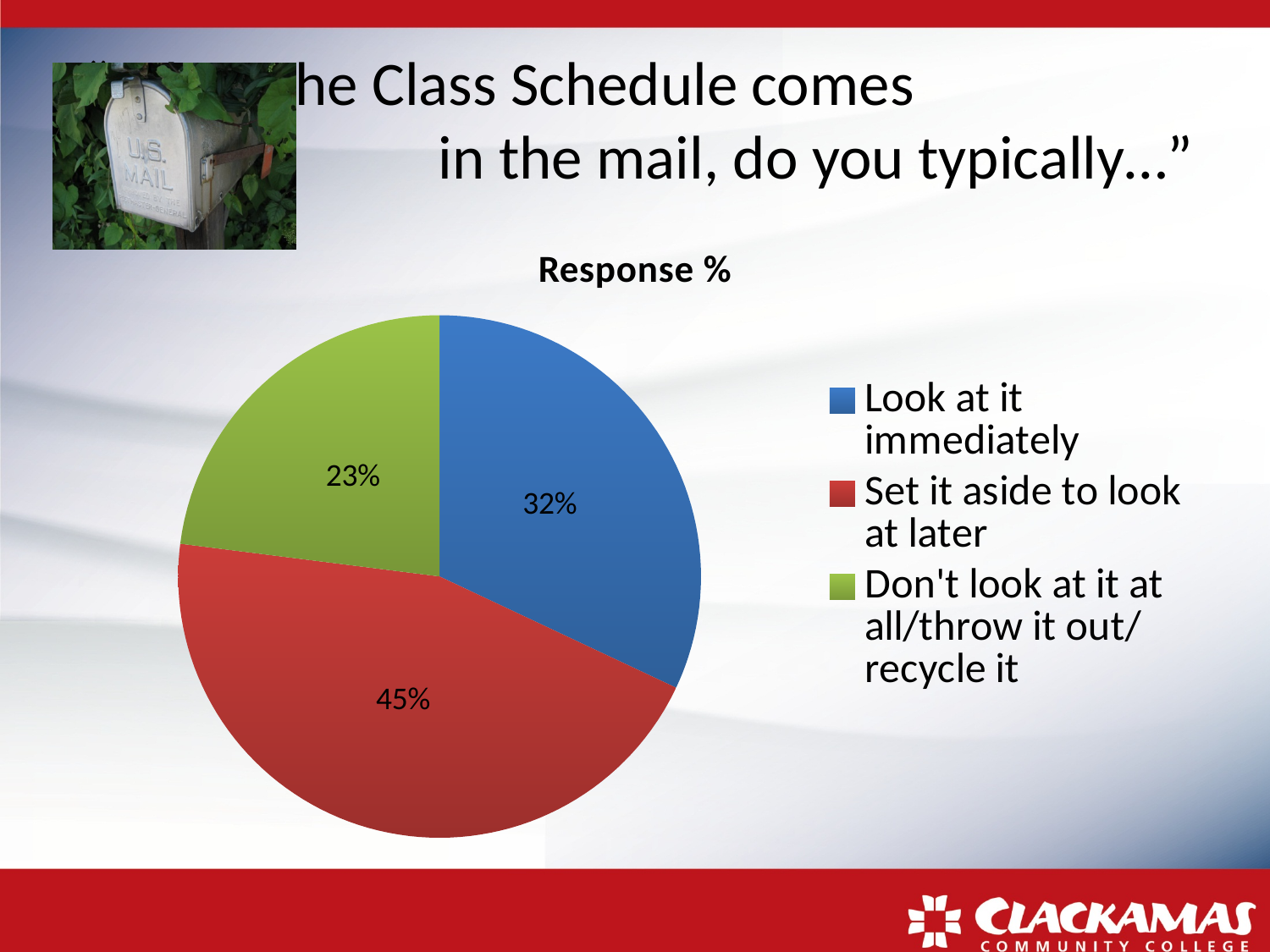
Which is larger: the share for 'Look at it immediately' or the share for 'Don't look at it at all/throw it out/recycle it'? Look at it immediately Which response has the largest share of the pie? Set it aside to look at later What percentage of respondents said they look at the Class Schedule immediately? 32% Which response has the smallest share of the pie? Don't look at it at all/throw it out/recycle it How many entries does the legend list? 3 How many slices does the pie chart have? 3 What type of chart is shown on the slide? pie chart What is the title of the chart? Response % What is the difference in percentage points between 'Set it aside to look at later' and 'Look at it immediately'? 13 What colour is the slice for 'Set it aside to look at later'? red What percentage of respondents said they don't look at the Class Schedule at all/throw it out/recycle it? 23% What percentage of respondents said they set the Class Schedule aside to look at later? 45%